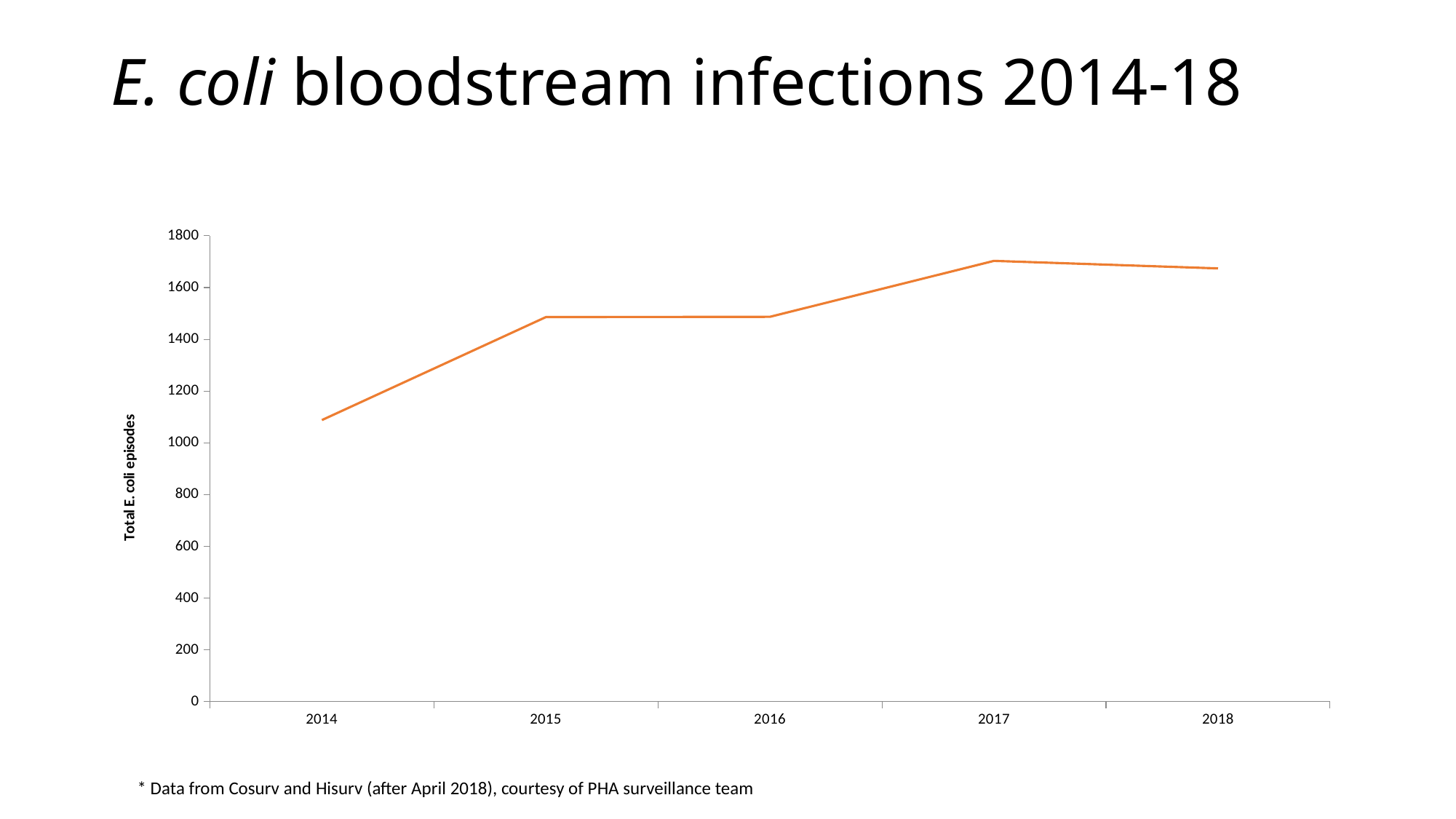
Which year has the lowest number of E. coli episodes? 2014 What is the label on the vertical axis of the chart? Total E. coli episodes How many years are plotted on the x axis of the chart? 5 What kind of chart is shown on the slide? line chart Is the value for 2014 greater or less than 1000? greater Is the value for 2017 greater or less than 1600? greater Which year has more E. coli episodes, 2014 or 2015? 2015 Is the value for 2014 greater or less than 1200? less Which year has the highest number of E. coli episodes? 2017 Overall, do the values rise or fall from 2014 to 2018? rise